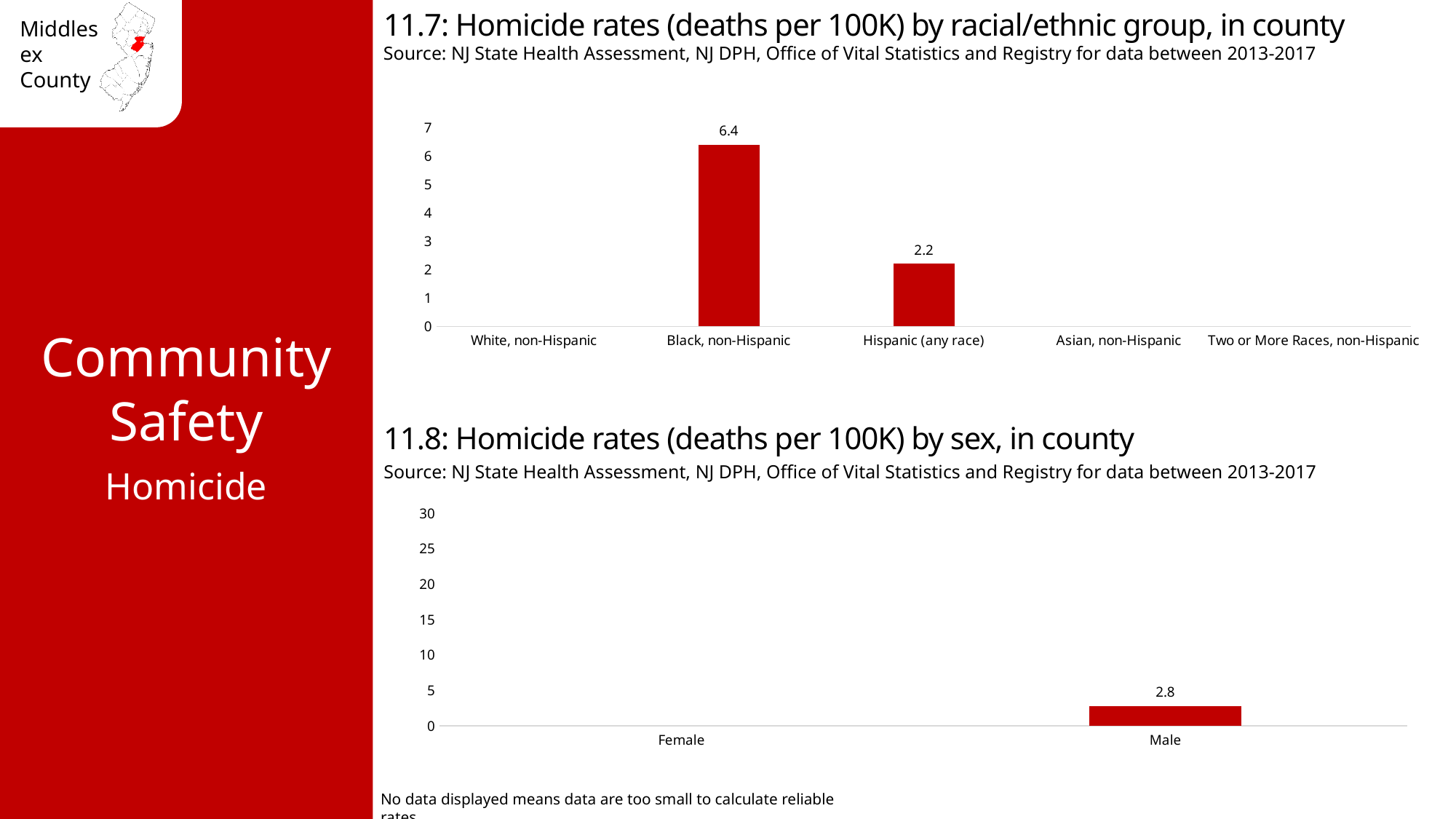
In the chart '11.7: Homicide rates (deaths per 100K) by racial/ethnic group, in county', how many categories have a bar displayed? 2 What kind of chart is '11.7: Homicide rates (deaths per 100K) by racial/ethnic group, in county'? Bar chart In the chart '11.7: Homicide rates (deaths per 100K) by racial/ethnic group, in county', how many racial/ethnic group categories are listed on the x axis? 5 In the chart '11.8: Homicide rates (deaths per 100K) by sex, in county', which category has no bar displayed? Female In the chart '11.7: Homicide rates (deaths per 100K) by racial/ethnic group, in county', what is the difference between the rates for Black, non-Hispanic and Hispanic (any race)? 4.2 In the chart '11.8: Homicide rates (deaths per 100K) by sex, in county', what is the homicide rate for Male? 2.8 In the chart '11.7: Homicide rates (deaths per 100K) by racial/ethnic group, in county', which is larger: the rate for Black, non-Hispanic or Hispanic (any race)? Black, non-Hispanic In the chart '11.7: Homicide rates (deaths per 100K) by racial/ethnic group, in county', what is the homicide rate for Hispanic (any race)? 2.2 In the chart '11.8: Homicide rates (deaths per 100K) by sex, in county', is the value for Male greater or less than 5? less In the chart '11.7: Homicide rates (deaths per 100K) by racial/ethnic group, in county', which group has the highest homicide rate shown? Black, non-Hispanic In the chart '11.7: Homicide rates (deaths per 100K) by racial/ethnic group, in county', what is the homicide rate for Black, non-Hispanic? 6.4 In the chart '11.8: Homicide rates (deaths per 100K) by sex, in county', what is the highest value shown on the y axis? 30